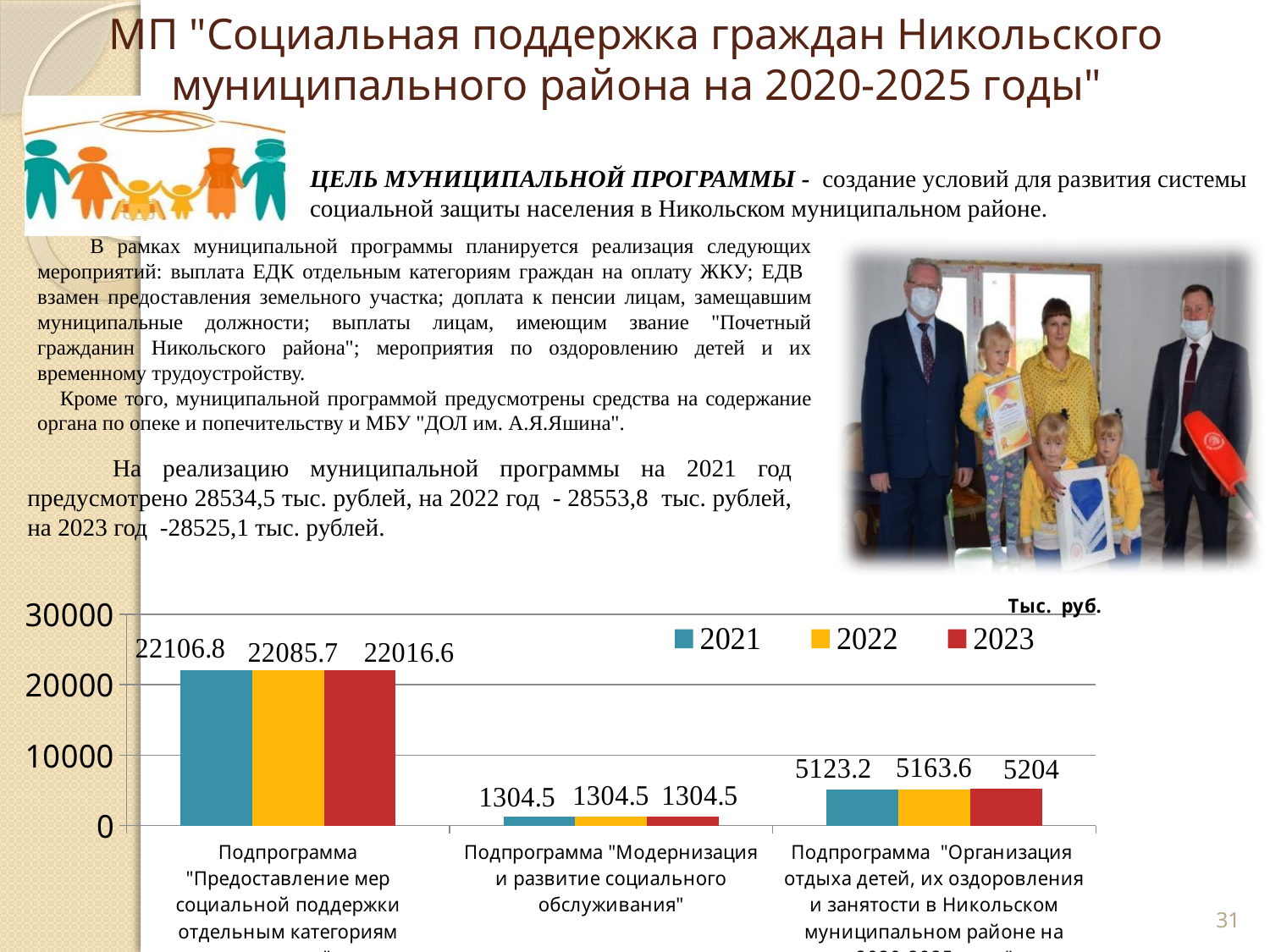
Which subprogram has the lowest values in the chart? Подпрограмма "Модернизация и развитие социального обслуживания" Is the 2022 value for the subprogram "Организация отдыха детей, их оздоровления и занятости" greater or less than 10000? less How many series does the chart legend list? 3 What kind of chart is shown on the slide? bar chart What is the 2023 value for the subprogram "Организация отдыха детей, их оздоровления и занятости"? 5204 Which subprogram has the highest values in the chart? Подпрограмма "Предоставление мер социальной поддержки отдельным категориям" For the subprogram "Предоставление мер социальной поддержки отдельным категориям", do the values rise or fall from 2021 to 2023? fall What is the difference between the 2023 and 2021 values for the subprogram "Организация отдыха детей, их оздоровления и занятости"? 80.8 What unit is indicated above the chart? Тыс. руб. How many subprogram categories are shown on the x axis of the chart? 3 What is the 2021 value for the subprogram "Модернизация и развитие социального обслуживания"? 1304.5 What is the 2022 value for the subprogram "Предоставление мер социальной поддержки отдельным категориям"? 22085.7